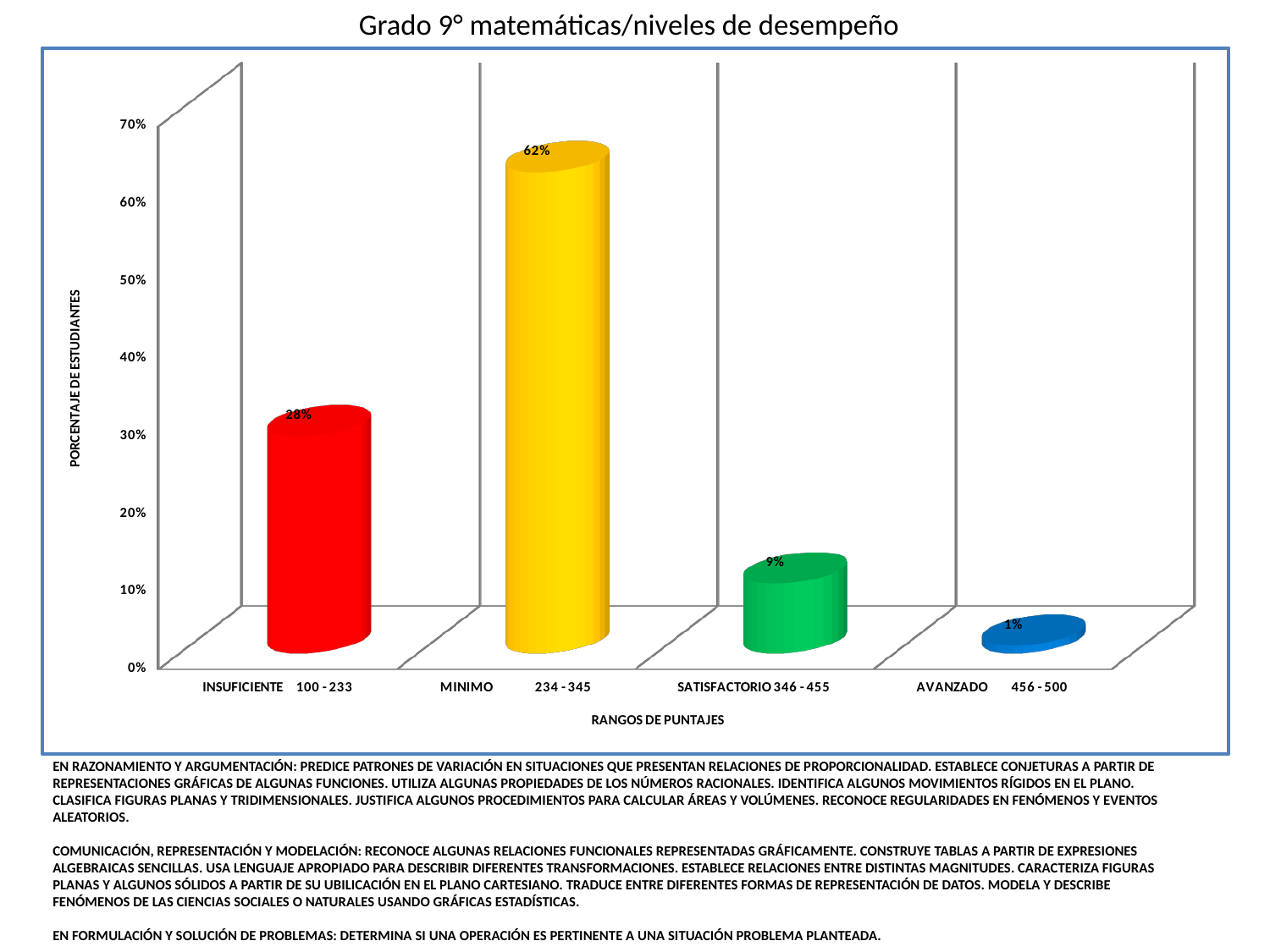
What percentage of students are at the MINIMO (234 - 345) level? 62% Which performance level has the lowest percentage of students? AVANZADO What percentage of students are at the AVANZADO (456 - 500) level? 1% What percentage of students are at the INSUFICIENTE (100 - 233) level? 28% Which performance level has the highest percentage of students? MINIMO What is the title of the chart? Grado 9° matemáticas/niveles de desempeño What is the label of the vertical axis? PORCENTAJE DE ESTUDIANTES What percentage of students are at the SATISFACTORIO (346 - 455) level? 9% How many performance levels are shown on the x axis? 4 What is the difference in percentage points between the MINIMO and INSUFICIENTE levels? 34 Which has a larger percentage of students, SATISFACTORIO or INSUFICIENTE? INSUFICIENTE What kind of chart is shown on the slide? Bar chart